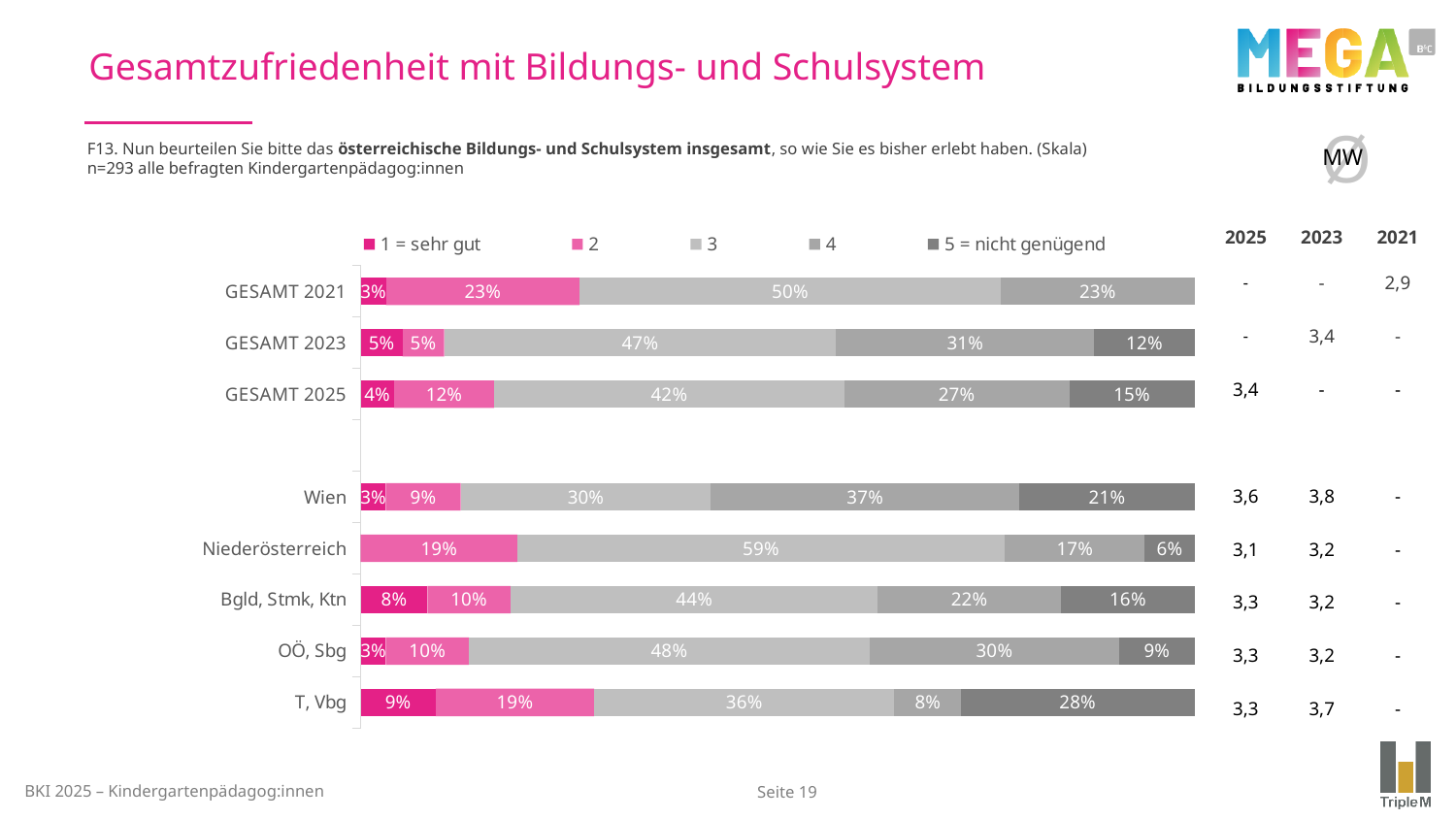
What is the share of '1 = sehr gut' for Bgld, Stmk, Ktn? 8% Which has a larger share of rating 2: T, Vbg or Bgld, Stmk, Ktn? T, Vbg How many percentage points higher is the rating-4 share for Wien than for GESAMT 2025? 10 percentage points What percentage of respondents gave a rating of 3 for GESAMT 2025? 42% How many categories (bars) are shown in the chart? 8 How many series does the legend list? 5 What is the MW (mean) value for Wien in 2025 shown next to the chart? 3,6 Which category has the highest share of rating 3? Niederösterreich Which category has the lowest share of '5 = nicht genügend'? GESAMT 2021 What is the share of '5 = nicht genügend' for T, Vbg? 28% What kind of chart is shown on the slide? Stacked bar chart Which category has the highest share of rating 4? Wien